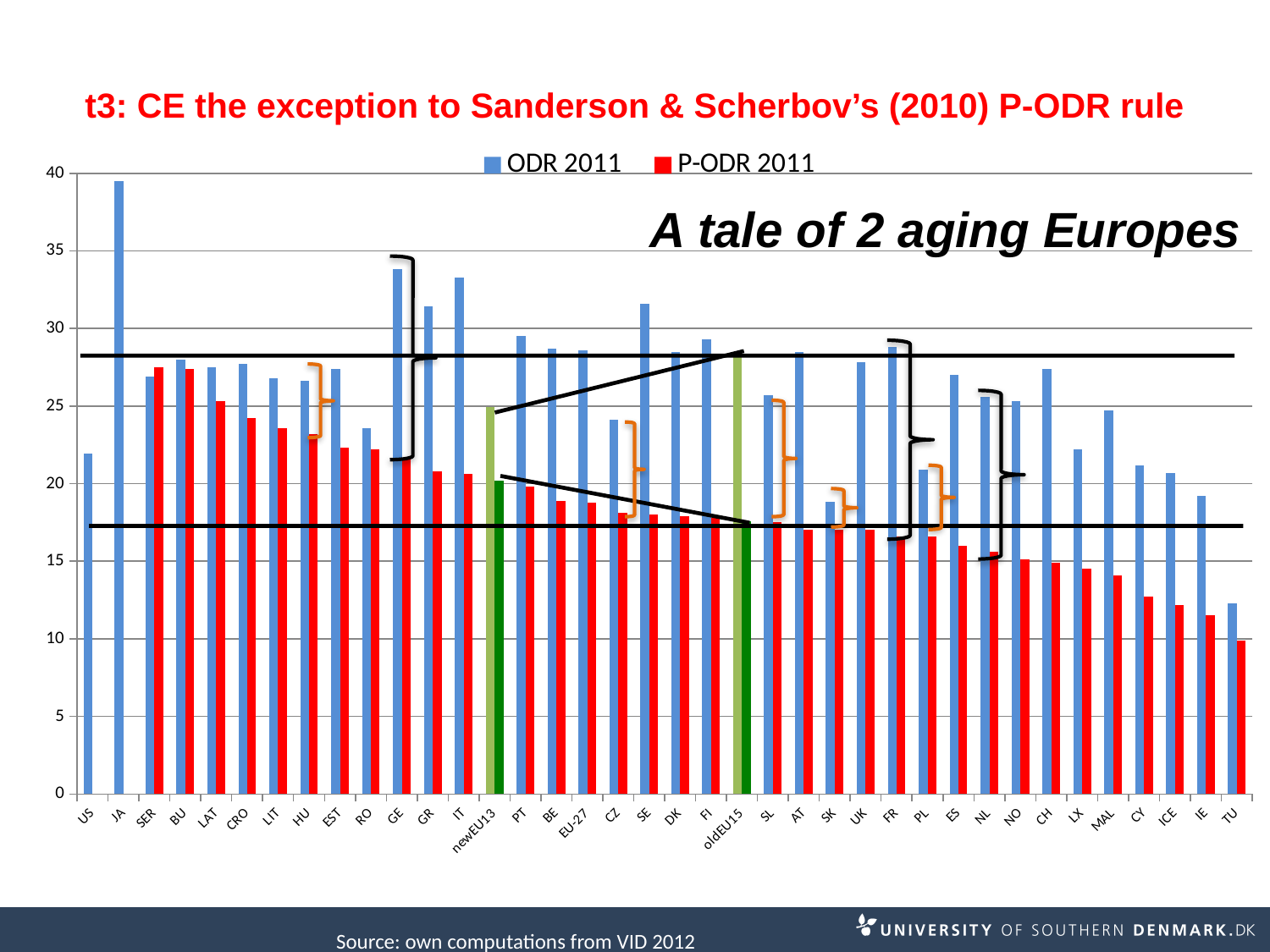
Which series is shown in red in the legend? P-ODR 2011 Is the ODR 2011 value for GE greater or less than 30? greater Which category has the lowest P-ODR 2011 value? TU How many series does the legend list? 2 Which is larger for GE, the ODR 2011 value or the P-ODR 2011 value? ODR 2011 What kind of chart is shown on the slide? bar chart Which category has the highest ODR 2011 value? JA Is the P-ODR 2011 value for CY greater or less than 15? less Which is larger, the ODR 2011 value for JA or the ODR 2011 value for US? JA Is the P-ODR 2011 value for SER greater or less than 25? greater Do the P-ODR 2011 values generally rise or fall from left to right along the x axis? fall